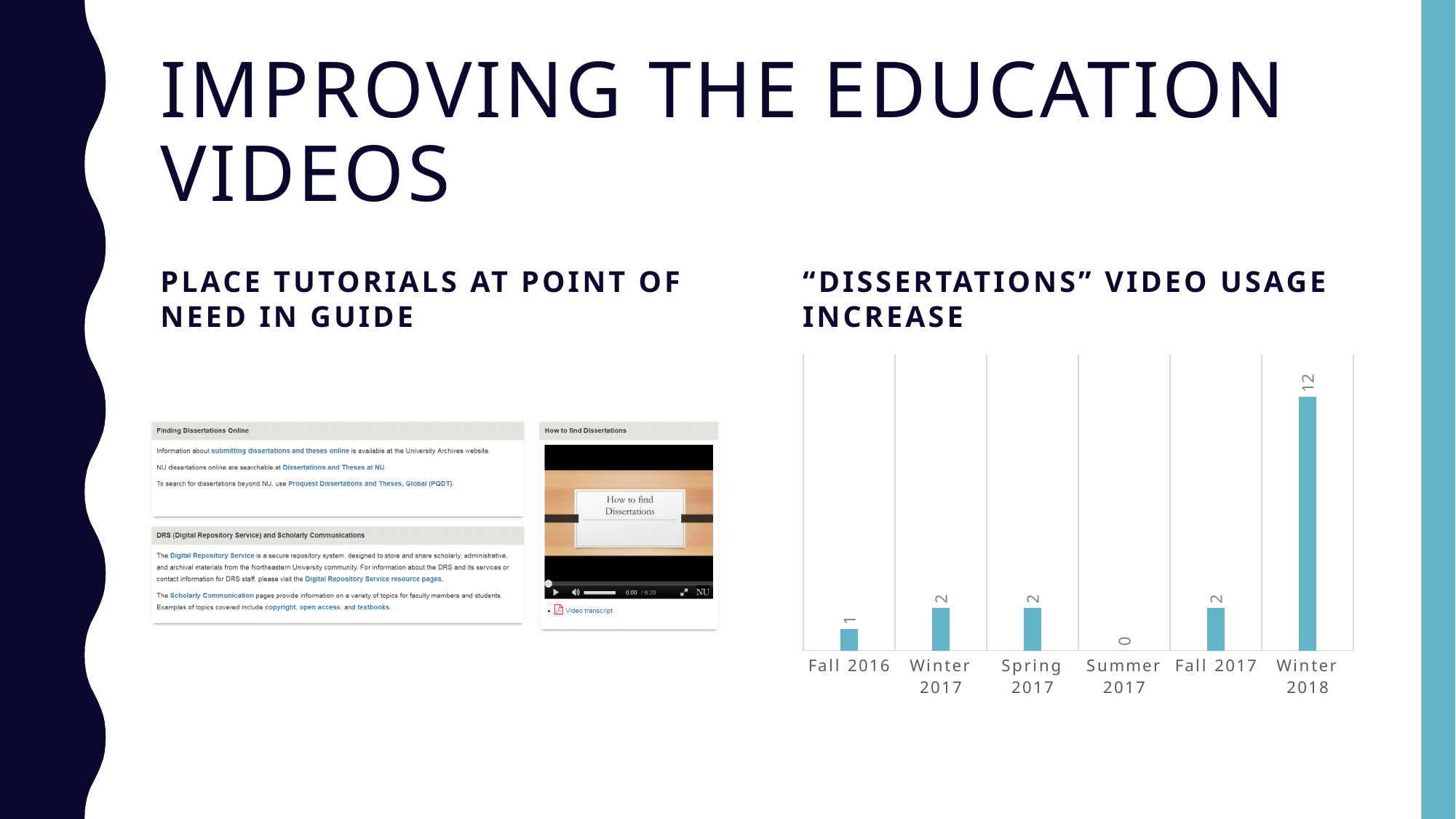
What kind of chart is shown on the slide? bar chart What is the value for Fall 2016? 1 What is the heading above the chart? "Dissertations" video usage increase What is the value for Winter 2018? 12 What is the value for Spring 2017? 2 What is the value for Summer 2017? 0 Which period has the lowest value? Summer 2017 Which is larger, the value for Fall 2016 or the value for Winter 2017? Winter 2017 Which period has the highest value? Winter 2018 What is the difference between the values for Winter 2018 and Fall 2017? 10 How many periods are shown on the x axis of the chart? 6 What is the difference between the values for Winter 2018 and Fall 2016? 11